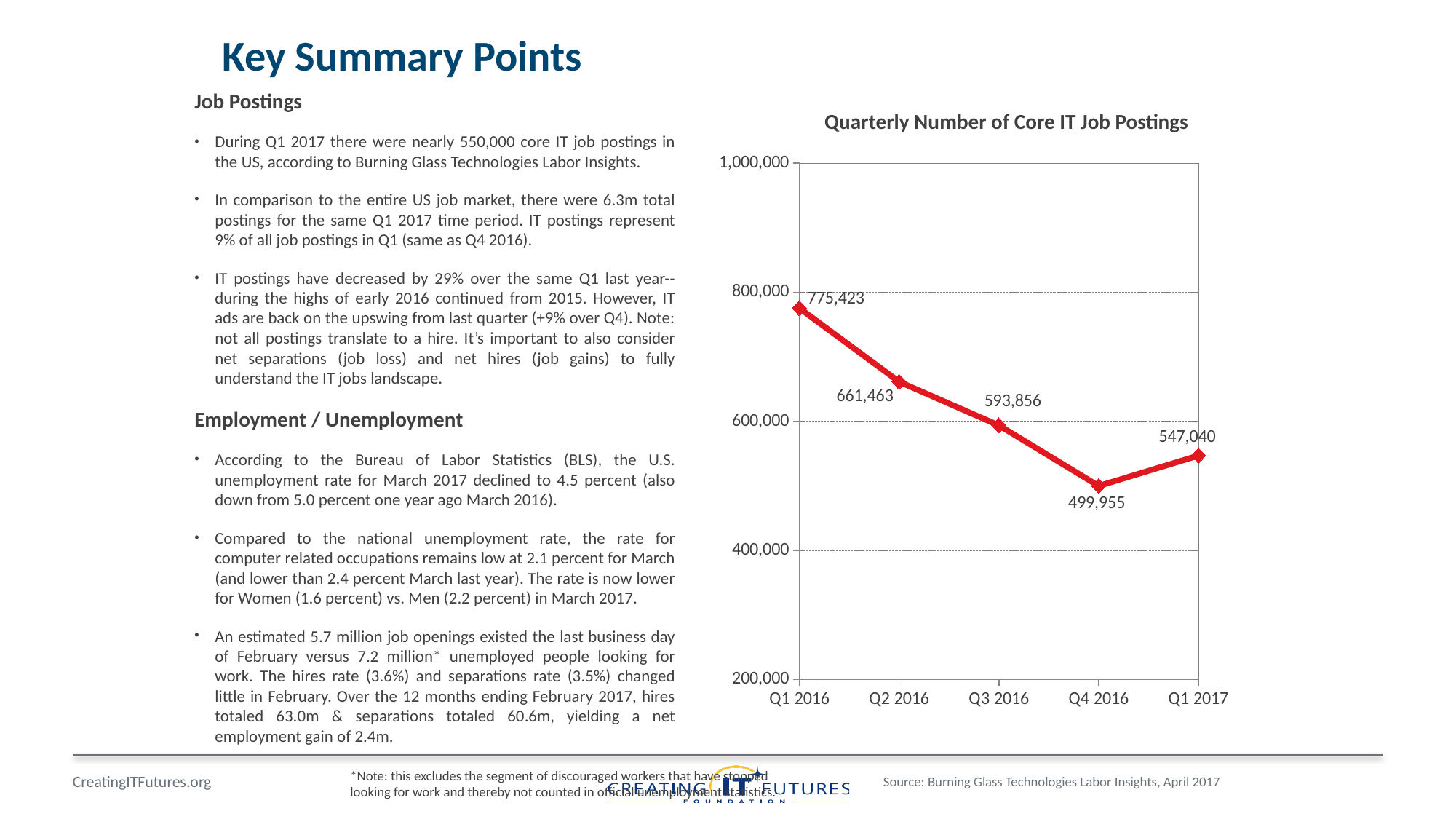
Is the value for Q2 2016 greater or less than 600,000? greater What is the difference in core IT job postings between Q2 2016 and Q3 2016? 67,607 What is the number of core IT job postings in Q4 2016? 499,955 Which quarter has the highest number of core IT job postings? Q1 2016 Which quarter has more core IT job postings, Q3 2016 or Q1 2017? Q3 2016 What is the title of the chart? Quarterly Number of Core IT Job Postings How many quarters are plotted on the chart? 5 What kind of chart is used to show the quarterly number of core IT job postings? Line chart What is the number of core IT job postings in Q1 2017? 547,040 Which quarter has the lowest number of core IT job postings? Q4 2016 What is the number of core IT job postings in Q1 2016? 775,423 What is the difference in core IT job postings between Q1 2016 and Q1 2017? 228,383